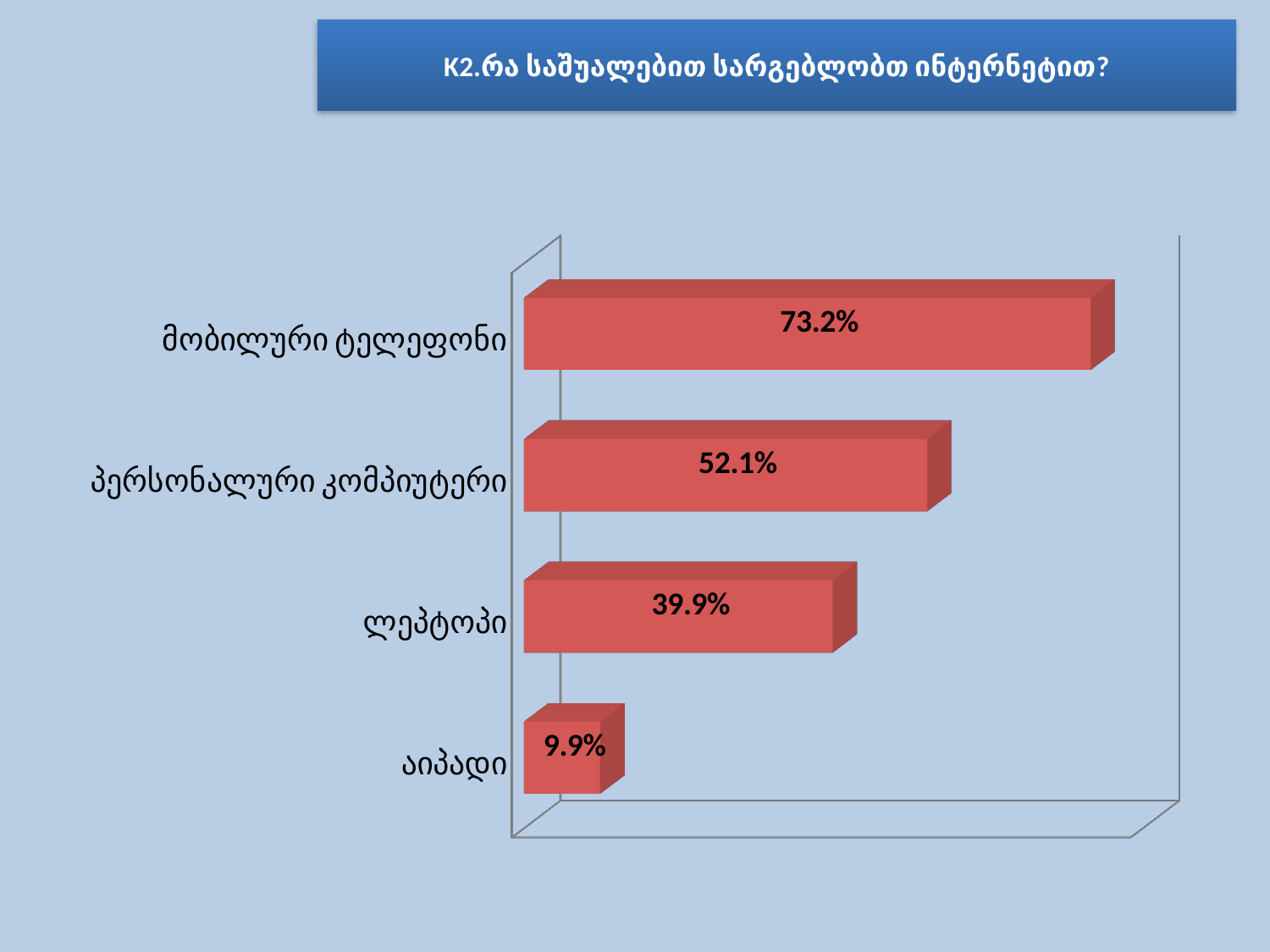
What is the value for აიპადი? 9.9% Which category has the highest value? მობილური ტელეფონი Which category has the lowest value? აიპადი What is the difference between the values for ლეპტოპი and აიპადი? 30.0% What is the value for ლეპტოპი? 39.9% What is the value for პერსონალური კომპიუტერი? 52.1% Which is larger, the value for პერსონალური კომპიუტერი or the value for ლეპტოპი? პერსონალური კომპიუტერი How many categories are shown in the chart? 4 What is the title of the chart? K2.რა საშუალებით სარგებლობთ ინტერნეტით? What is the difference between the values for მობილური ტელეფონი and პერსონალური კომპიუტერი? 21.1% What is the value for მობილური ტელეფონი? 73.2% What kind of chart is shown on the slide? Bar chart